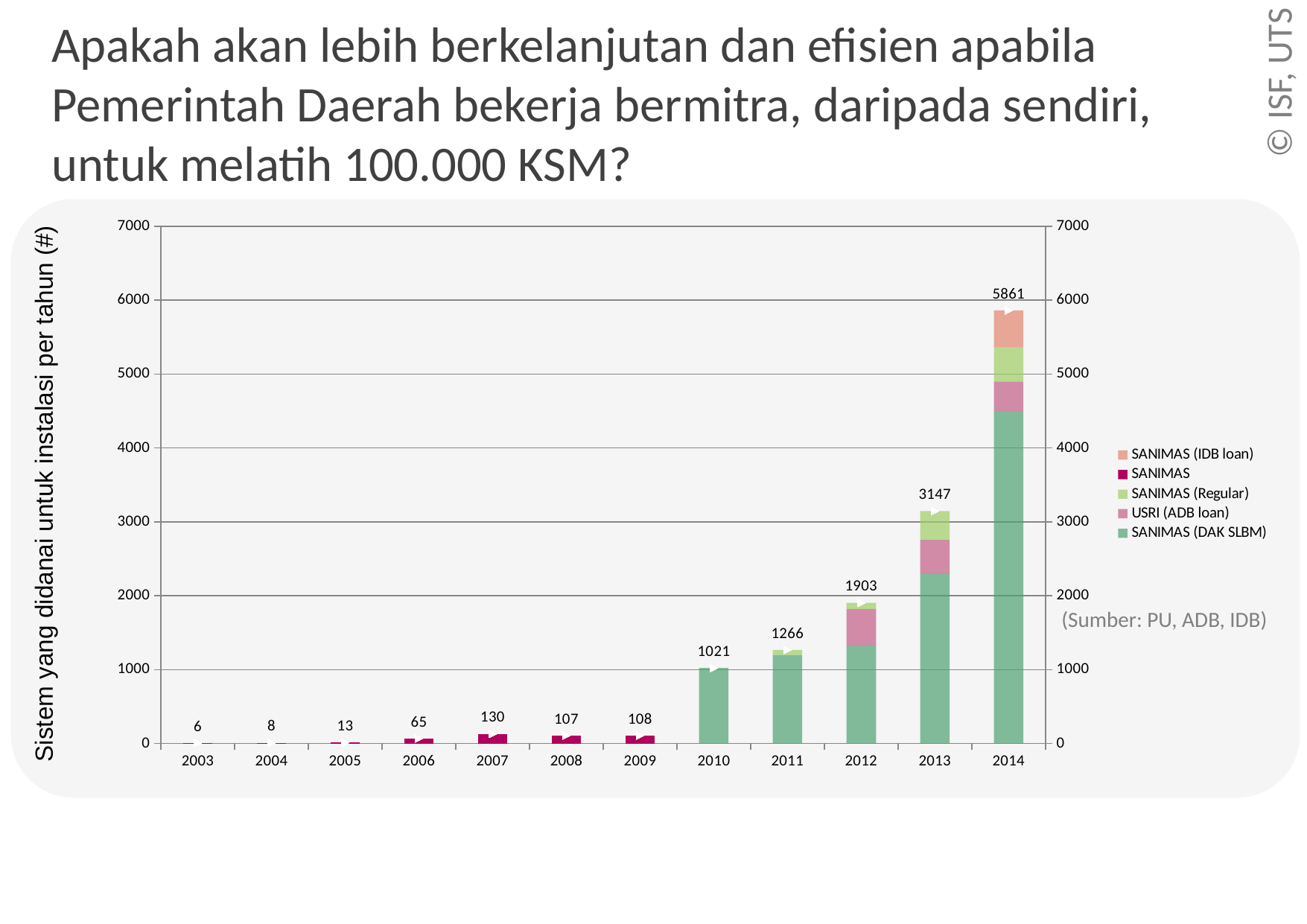
Which year has the highest total? 2014 How many years are shown on the x axis? 12 What is the total value shown for 2014? 5861 How many series does the legend list? 5 What is the total value shown for 2007? 130 Do the totals generally rise or fall from 2009 to 2014? Rise What is the total value shown for 2010? 1021 Which year has a larger total, 2008 or 2009? 2009 Which year has the lowest total? 2003 Is the SANIMAS (DAK SLBM) value for 2014 greater or less than 4000? greater What kind of chart is shown on the slide? Stacked bar chart What is the difference between the totals for 2014 and 2013? 2714